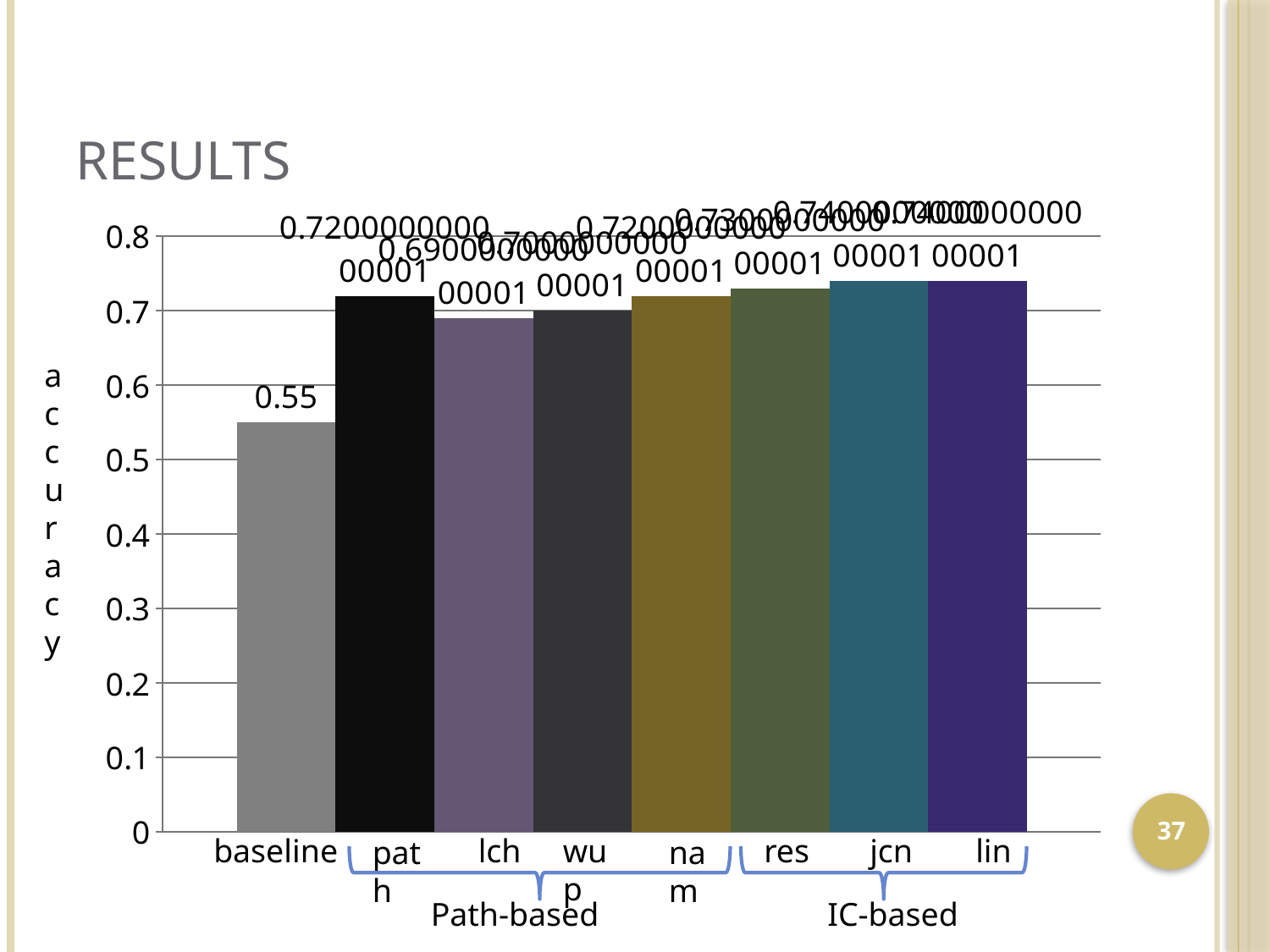
What is the accuracy value shown for the baseline bar? 0.55 Which has a higher accuracy, baseline or path? path Which group of methods is labelled 'IC-based' under the chart? res, jcn, lin Which category has the lowest accuracy? baseline Is the accuracy for jcn greater or less than 0.7? greater Which has a higher accuracy, lch or nam? nam What is the label on the vertical axis of the chart? accuracy What kind of chart is shown on the slide? bar chart Is the accuracy for res greater or less than 0.7? greater Is the accuracy for path greater or less than 0.7? greater How many bars are plotted in the chart? 8